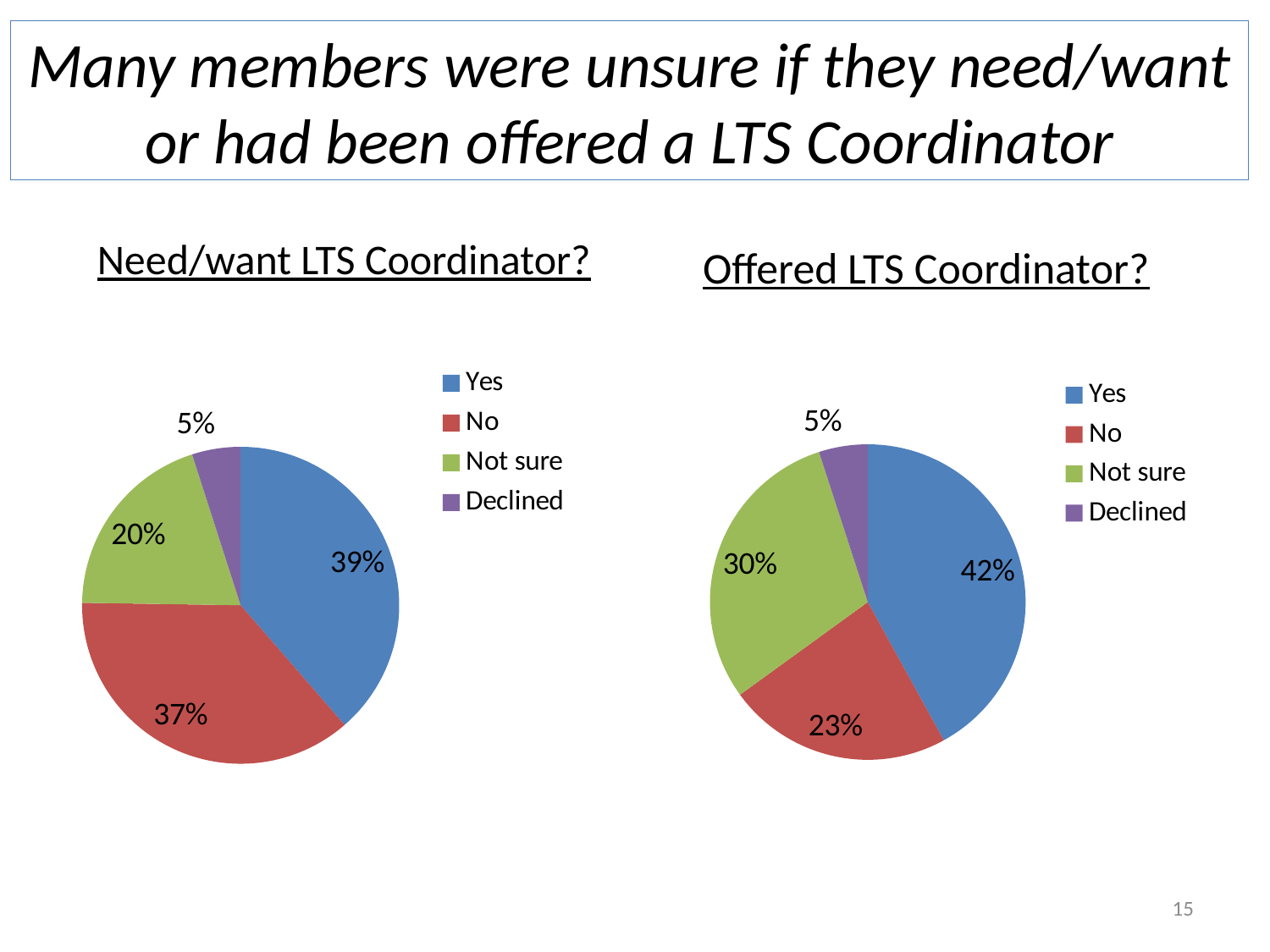
In the 'Offered LTS Coordinator?' chart, what is the difference between the 'Yes' and 'No' shares? 19% In the 'Offered LTS Coordinator?' chart, what share of the pie is 'Yes'? 42% In the 'Need/want LTS Coordinator?' chart, which category has the smallest slice? Declined In the 'Need/want LTS Coordinator?' chart, which is larger, 'No' or 'Not sure'? No How many categories does the legend of the 'Need/want LTS Coordinator?' chart list? 4 In the 'Need/want LTS Coordinator?' chart, what share of the pie is 'No'? 37% In the 'Offered LTS Coordinator?' chart, what share of the pie is 'Declined'? 5% In the 'Offered LTS Coordinator?' chart, which category has the largest slice? Yes What type of chart is the 'Offered LTS Coordinator?' chart? Pie chart